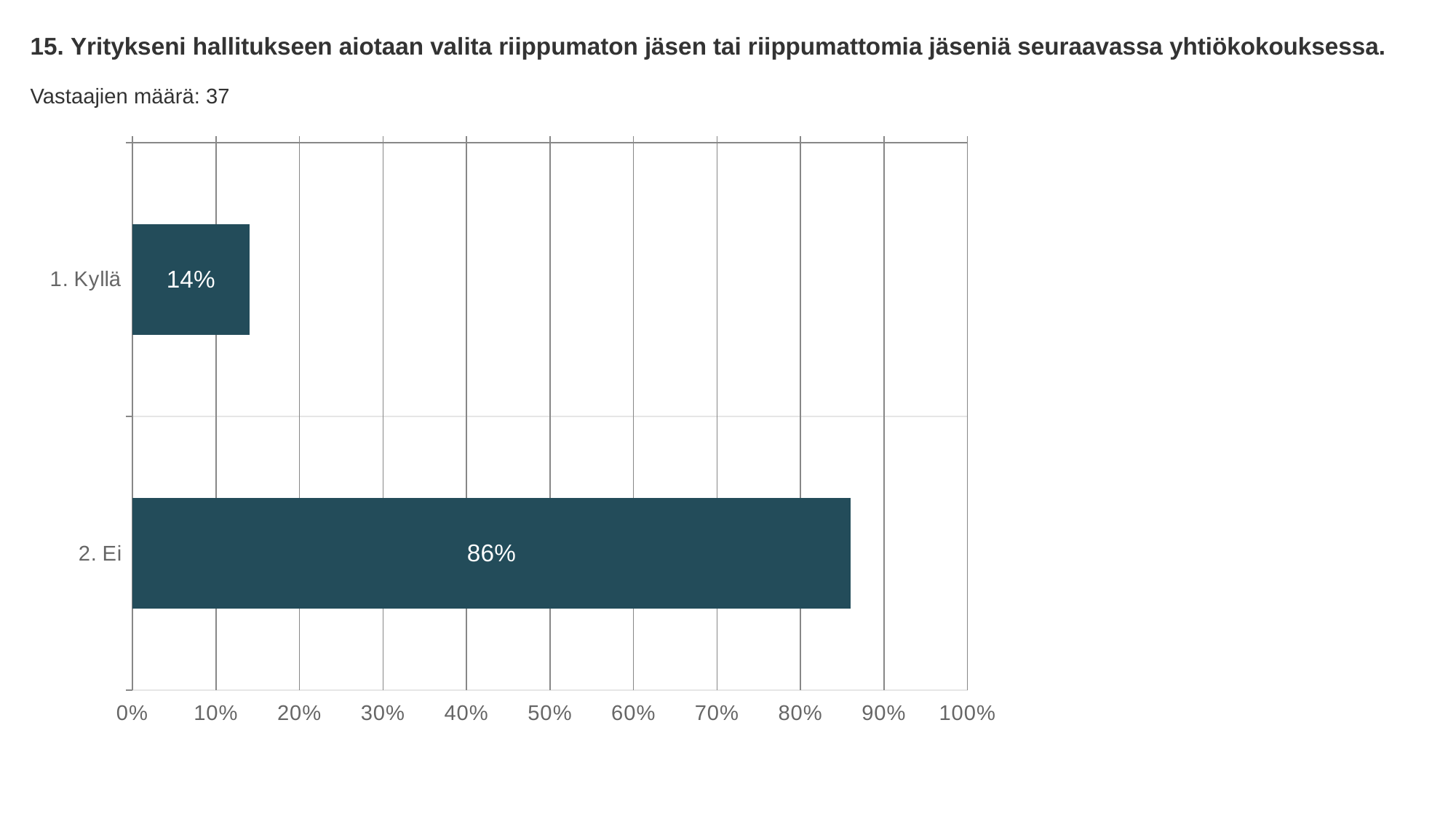
What is the value for "1. Kyllä"? 14% How many categories are shown in the chart? 2 Which is larger, the value for "1. Kyllä" or the value for "2. Ei"? 2. Ei What is the difference between the values for "2. Ei" and "1. Kyllä"? 72% What is the number of respondents (Vastaajien määrä) shown on the slide? 37 Is the value for "1. Kyllä" greater or less than 20%? less Which category has the highest value? 2. Ei What kind of chart is shown on the slide? Bar chart Is the value for "2. Ei" greater or less than 80%? greater Which category has the lowest value? 1. Kyllä What is the value for "2. Ei"? 86% What is the maximum value shown on the horizontal axis? 100%